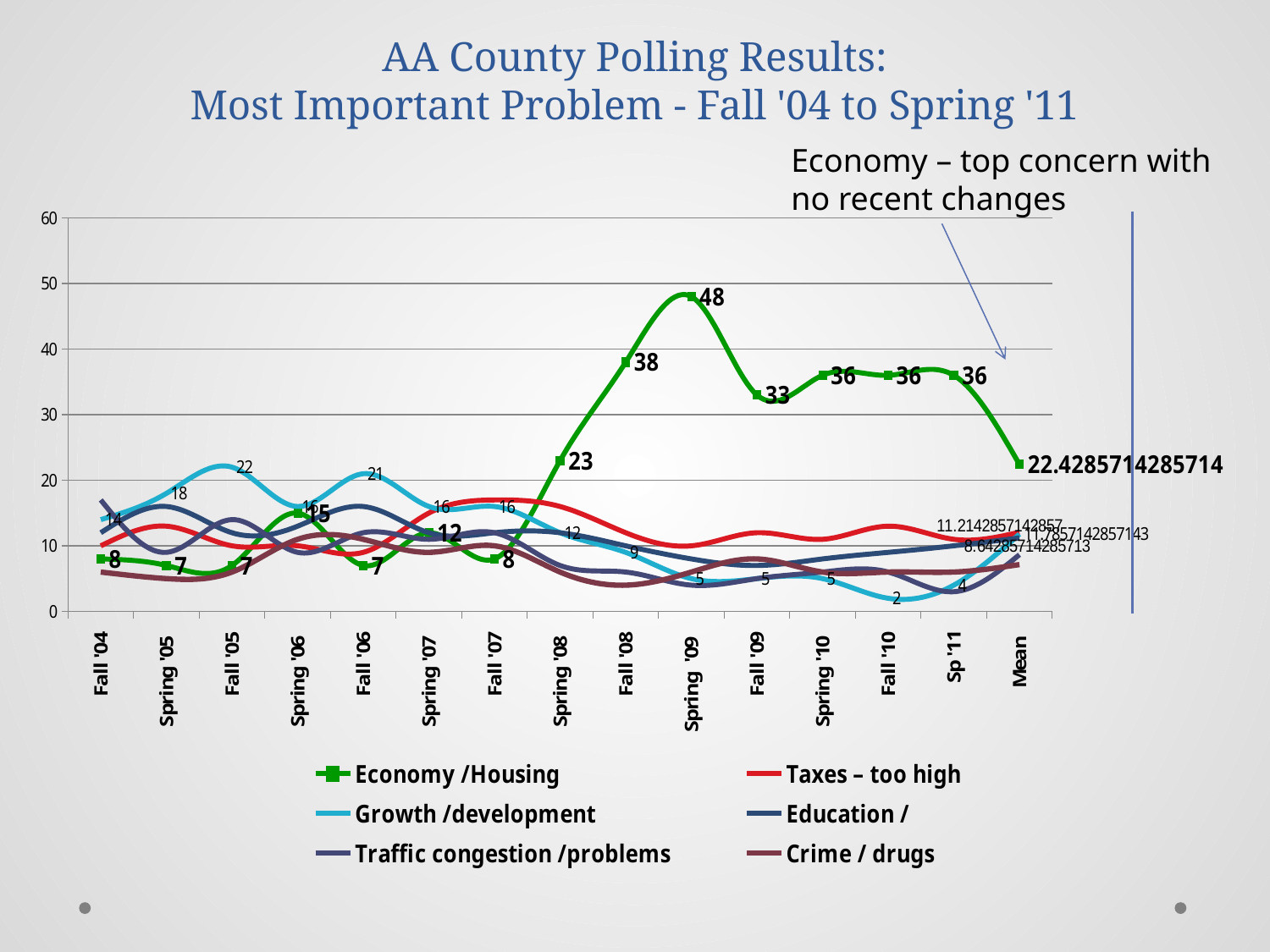
Does the Economy /Housing series rise or fall from Fall '07 to Spring '09? rise How many series does the legend list? 6 In which period does the Economy /Housing series reach its highest value? Spring '09 Which is larger for Economy /Housing: the value in Fall '07 or the value in Spring '08? Spring '08 What is the value for Economy /Housing in Fall '08? 38 What kind of chart is shown on the slide? line chart What is the difference between the Economy /Housing values for Spring '09 and Fall '08? 10 What is the value for Growth /development in Fall '05? 22 What is the value for Economy /Housing in Spring '09? 48 How many categories are shown along the x axis? 15 Is the value for Taxes – too high in Fall '07 greater or less than 10? greater What is the Mean value shown for Economy /Housing? 22.4285714285714